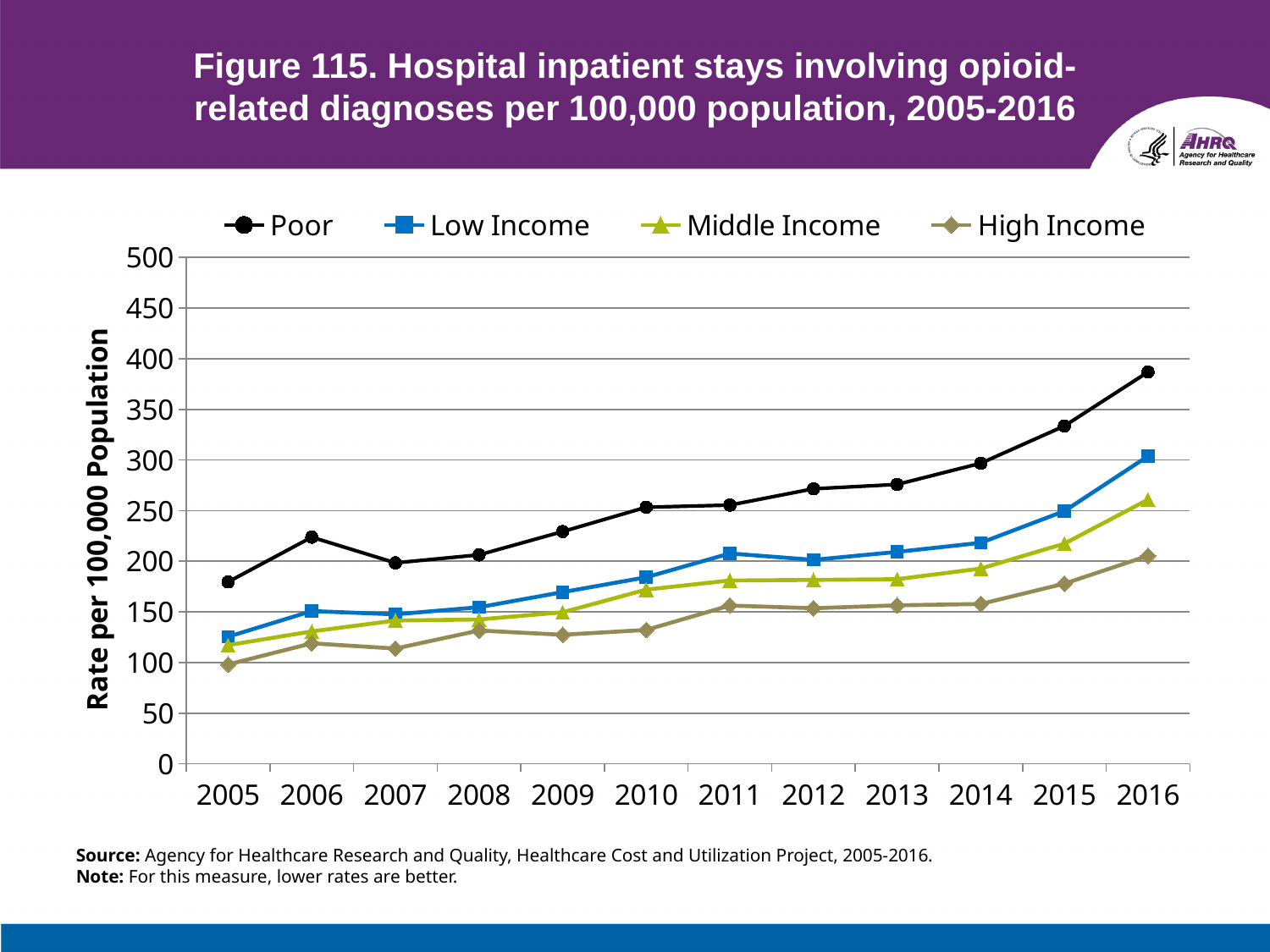
Which is larger for the Poor series, the value in 2006 or the value in 2007? 2006 Is the value for Poor in 2016 greater or less than 350? greater How many years are plotted along the x axis? 12 Which income group has the highest rate in 2016? Poor Is the value for Middle Income in 2016 greater or less than 250? greater Which income group has the lowest rate in 2005? High Income Is the value for Poor in 2005 greater or less than 200? less What kind of chart is shown on the slide? line chart How many series does the legend list? 4 In which year is the rate for the Poor series highest? 2016 In which year is the rate for the Poor series lowest? 2005 Does the High Income series generally rise or fall from 2005 to 2016? rise